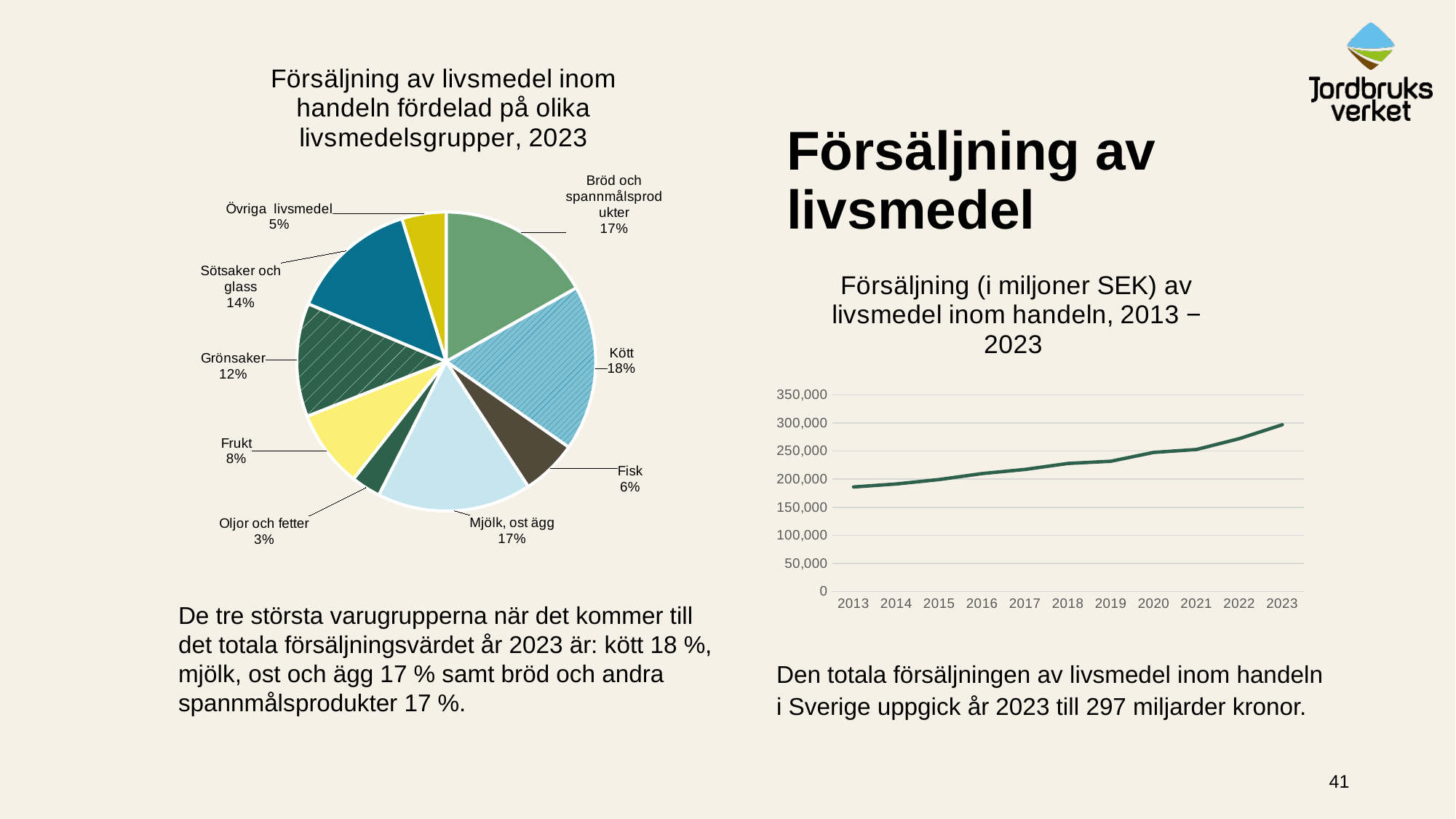
In the pie chart on the left, which is larger, Fisk or Frukt? Frukt In the pie chart on the left, which category has the smallest share? Oljor och fetter In the pie chart on the left, what is the difference in percentage points between Sötsaker och glass and Frukt? 6 In the line chart on the right, is the value for 2013 greater or less than 200,000? less In the line chart on the right, is the value for 2019 greater or less than 200,000? greater In the pie chart on the left, what share does Grönsaker have? 12% In the pie chart on the left, what share does Kött have? 18% What kind of chart is the chart on the right of the slide? Line chart In the line chart on the right, do the values rise or fall from 2013 to 2023? Rise How many categories does the pie chart on the left show? 9 In the pie chart on the left, what share does Sötsaker och glass have? 14% In the pie chart on the left, which category has the largest share? Kött